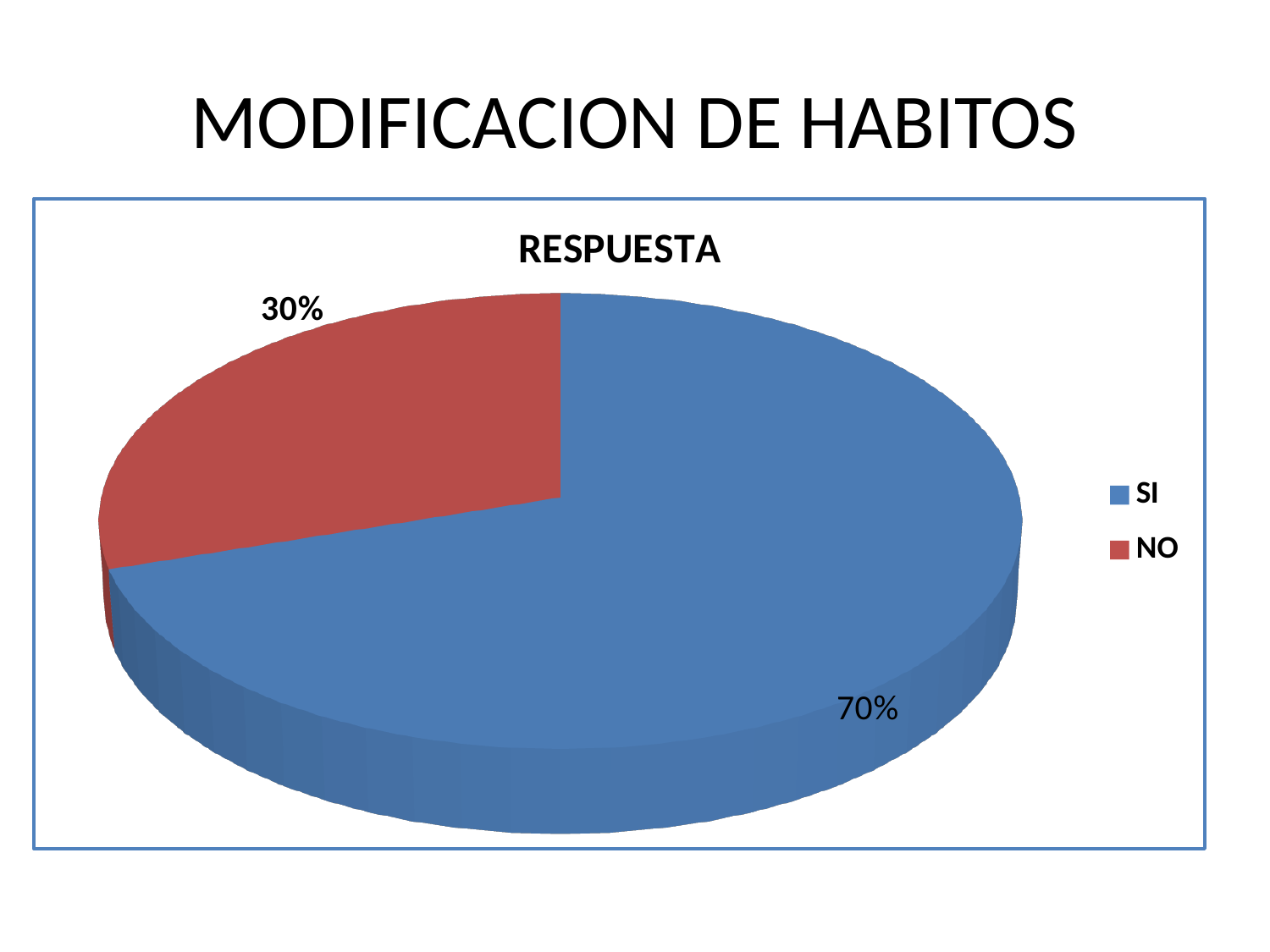
Which category has the smallest slice? NO Which is larger, SI or NO? SI What is the difference between the SI and NO values? 40% How many entries does the legend list? 2 What is the value for NO? 30% What is the title of the chart? RESPUESTA How many slices does the pie chart have? 2 What kind of chart is shown on the slide? pie chart What share of the pie does the SI slice represent? 70% What is the value for SI? 70% Which category has the largest slice? SI What colour is the NO slice? red